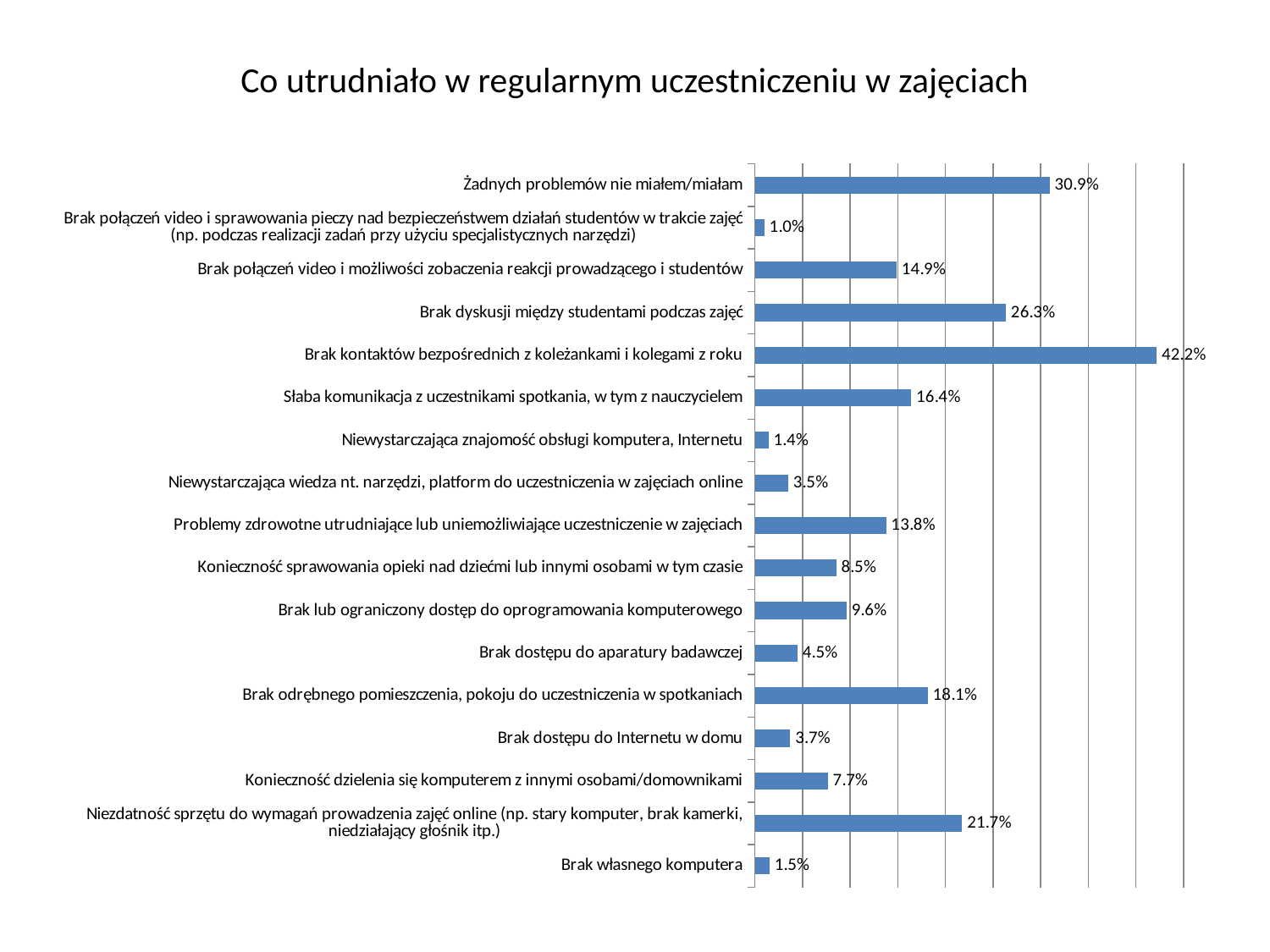
How many categories are shown in the chart? 17 Which category has the highest value? Brak kontaktów bezpośrednich z koleżankami i kolegami z roku What is the value for "Brak kontaktów bezpośrednich z koleżankami i kolegami z roku"? 42.2% Which is larger: the value for "Niezdatność sprzętu do wymagań prowadzenia zajęć online (np. stary komputer, brak kamerki, niedziałający głośnik itp.)" or for "Słaba komunikacja z uczestnikami spotkania, w tym z nauczycielem"? Niezdatność sprzętu do wymagań prowadzenia zajęć online (np. stary komputer, brak kamerki, niedziałający głośnik itp.) What is the value for "Brak odrębnego pomieszczenia, pokoju do uczestniczenia w spotkaniach"? 18.1% What is the value for "Żadnych problemów nie miałem/miałam"? 30.9% What is the value for "Brak dostępu do Internetu w domu"? 3.7% What is the title of the chart? Co utrudniało w regularnym uczestniczeniu w zajęciach Which category has the lowest value? Brak połączeń video i sprawowania pieczy nad bezpieczeństwem działań studentów w trakcie zajęć (np. podczas realizacji zadań przy użyciu specjalistycznych narzędzi) Which is larger: the value for "Konieczność sprawowania opieki nad dziećmi lub innymi osobami w tym czasie" or for "Brak lub ograniczony dostęp do oprogramowania komputerowego"? Brak lub ograniczony dostęp do oprogramowania komputerowego What kind of chart is shown on the slide? Bar chart What is the difference between the values for "Brak dyskusji między studentami podczas zajęć" and "Brak połączeń video i możliwości zobaczenia reakcji prowadzącego i studentów"? 11.4%